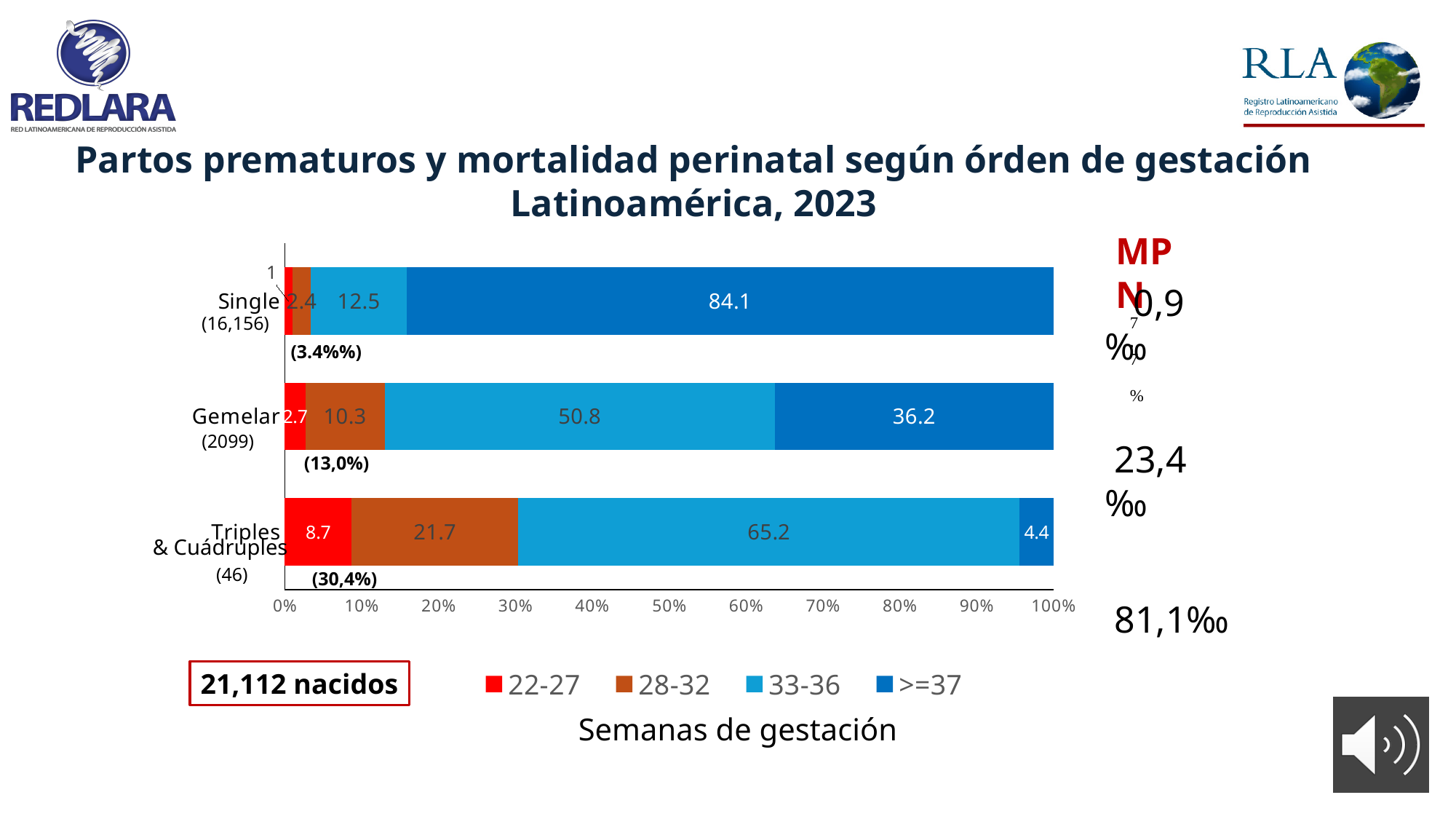
Which category has the highest value for the >=37 weeks series? Single How many gestation-order categories are plotted on the chart? 3 What is the value of the >=37 weeks segment for Single? 84.1 What is the x-axis title of the chart? Semanas de gestación Which is larger: the 28-32 weeks value for Gemelar or for Single? Gemelar What is the value of the 22-27 weeks segment for Triples & Cuádruples? 8.7 What is the value of the 33-36 weeks segment for Gemelar? 50.8 What is the value of the 28-32 weeks segment for Triples & Cuádruples? 21.7 How many series does the legend list? 4 What kind of chart is shown on the slide? Stacked bar chart Which category has the lowest value for the 22-27 weeks series? Single What is the difference between the 33-36 weeks values for Triples & Cuádruples and Gemelar? 14.4